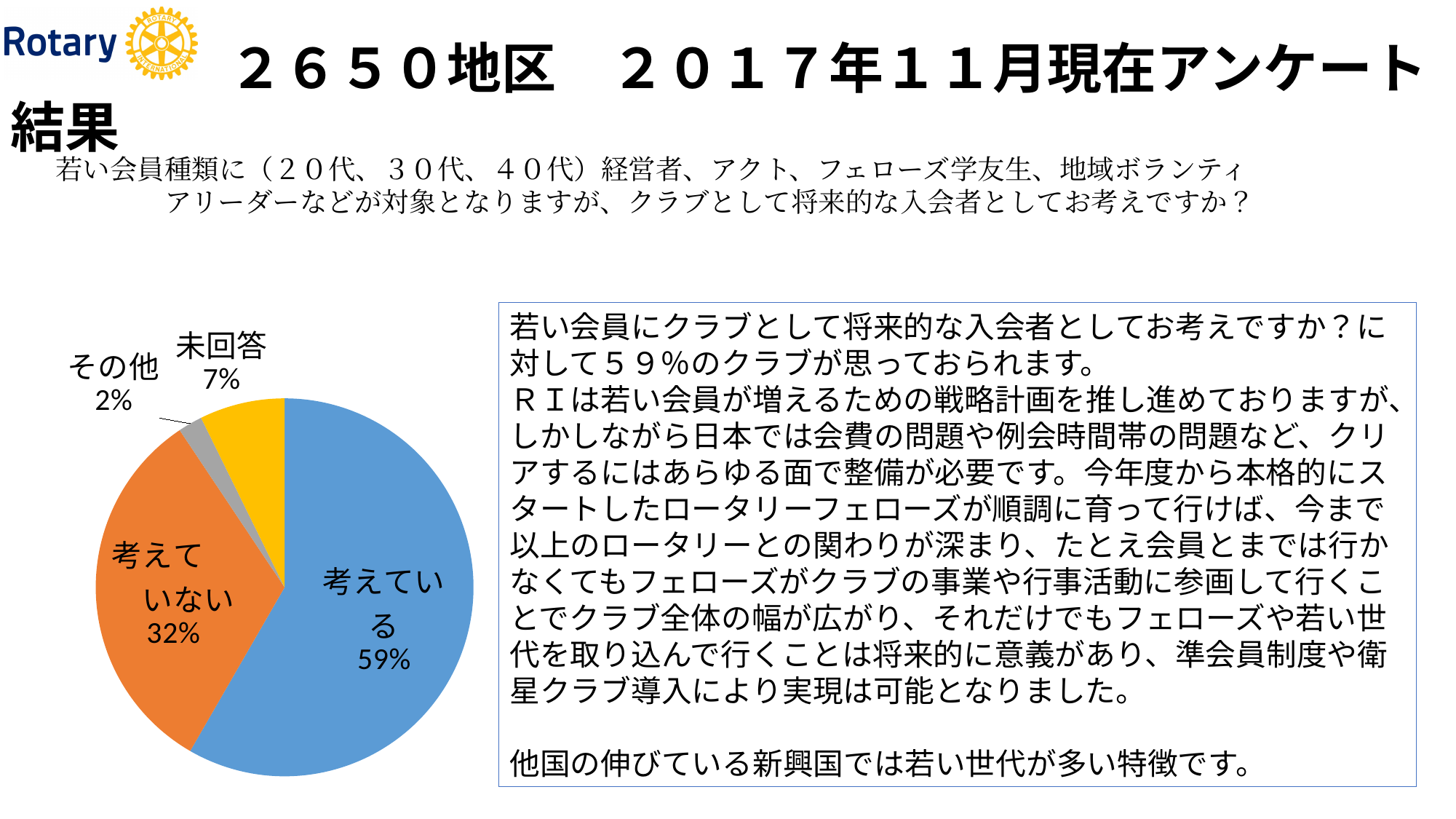
Which is larger, the slice for 未回答 or the slice for その他? 未回答 What share of the pie does その他 represent? 2% What share of the pie does 考えていない represent? 32% How many slices does the pie chart have? 4 Which category has the smallest slice of the pie? その他 What share of the pie does 未回答 represent? 7% What share of the pie does 考えている represent? 59% What is the difference in percentage points between 考えている and 考えていない? 27 Which category has the largest slice of the pie? 考えている What colour is the slice for 考えている? blue What colour is the slice for 未回答? yellow What kind of chart is shown on the slide? pie chart